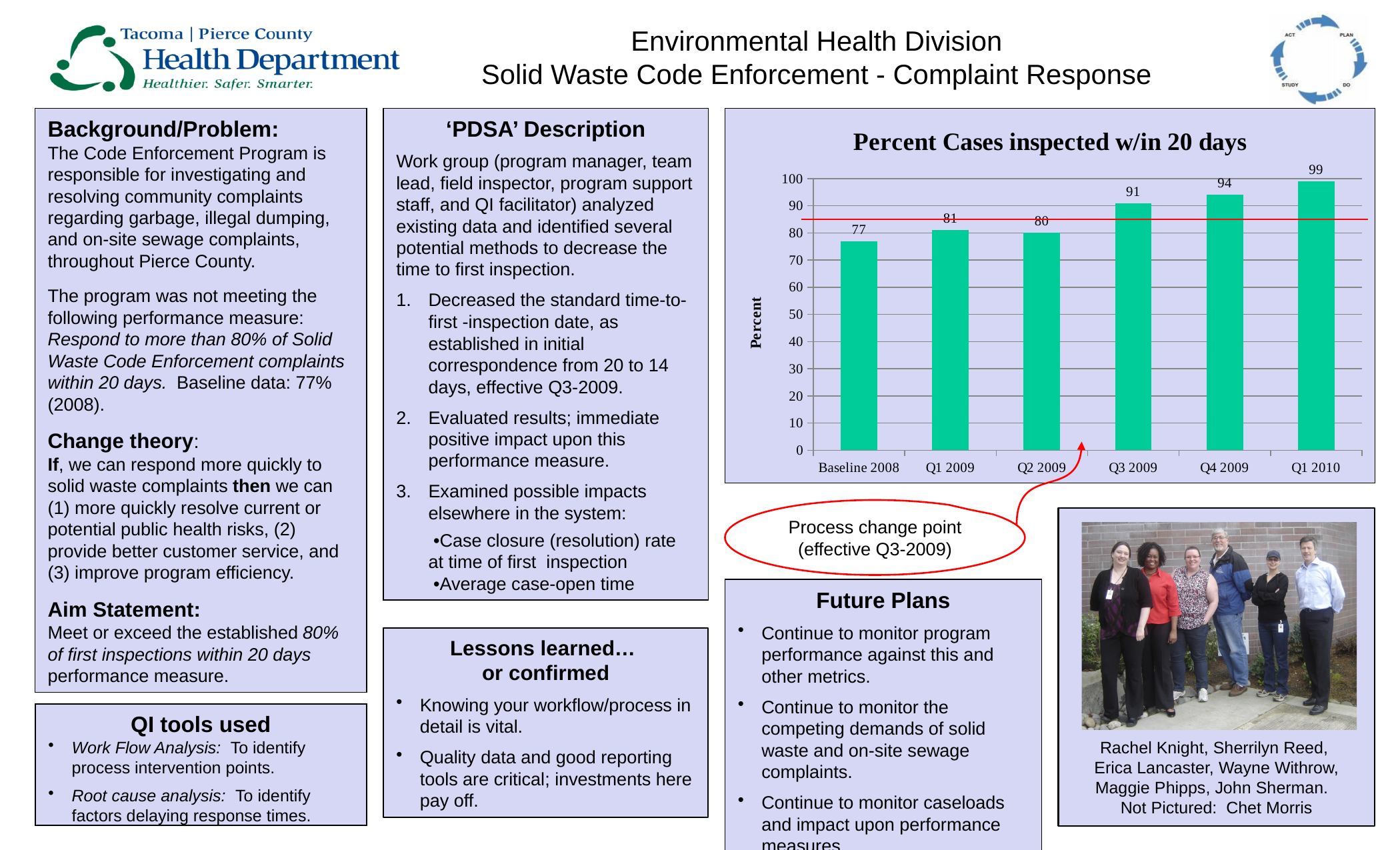
Which is larger, the value for Q1 2009 or the value for Q2 2009? Q1 2009 What is the title of the chart? Percent Cases inspected w/in 20 days What kind of chart is shown on the slide? bar chart How many categories are shown on the x axis of the chart? 6 Which category has the lowest value in the chart? Baseline 2008 What is the difference between the values for Q1 2010 and Baseline 2008? 22 What is the value for Q3 2009 in the chart? 91 What is the difference between the values for Q4 2009 and Q3 2009? 3 What is the value for Baseline 2008 in the chart? 77 What is the value for Q1 2010 in the chart? 99 Which category has the highest value in the chart? Q1 2010 Is the value for Q2 2009 greater or less than 90? less